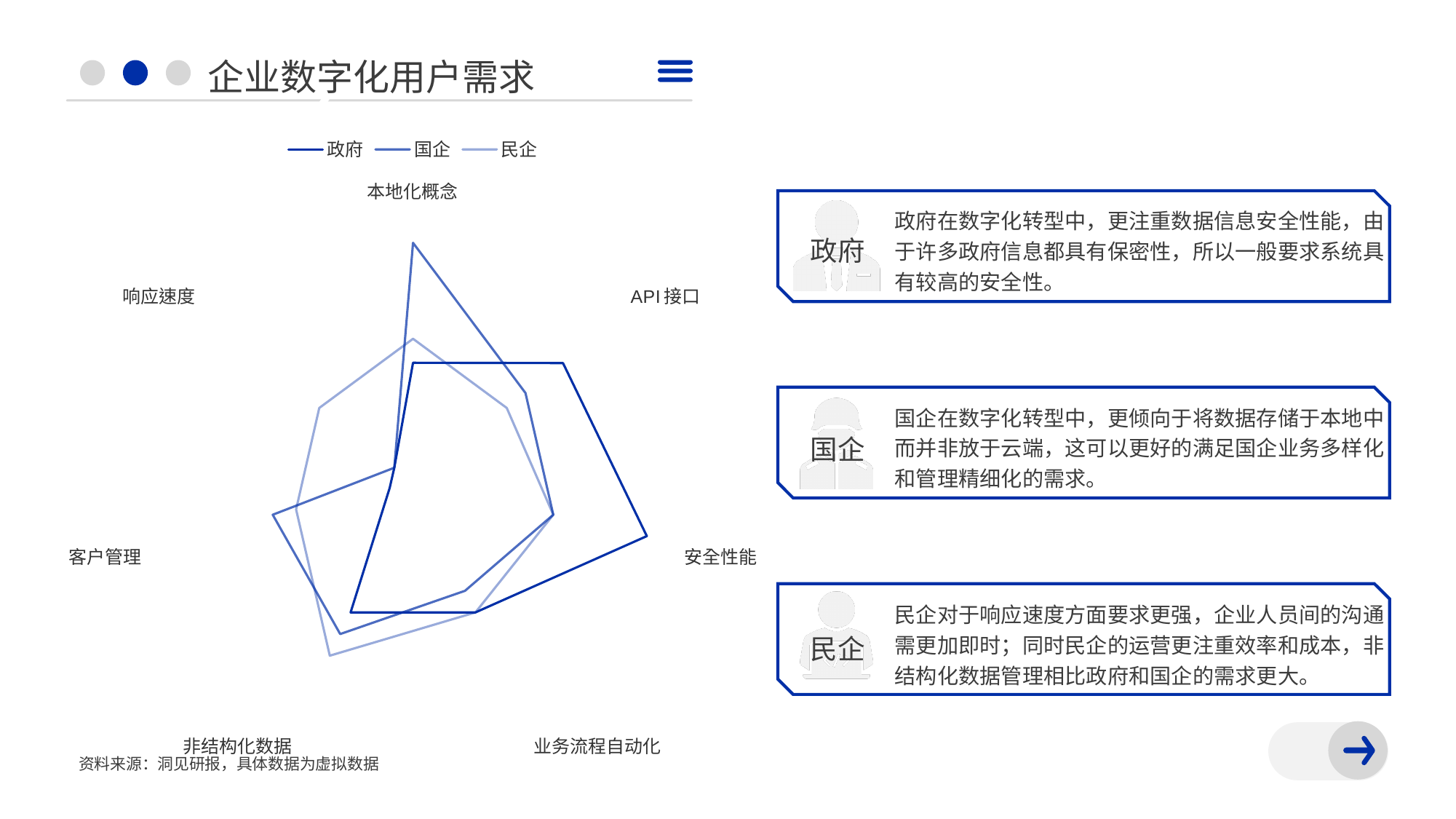
Which series has the highest value on the 非结构化数据 axis? 民企 How many series does the chart legend list? 3 Which series has the highest value on the 安全性能 axis? 政府 Which series are listed in the chart legend? 政府, 国企, 民企 What kind of chart is shown on the slide? Radar chart How many categories (axes) does the radar chart have? 7 What is the title of the slide containing the radar chart? 企业数字化用户需求 Which series has the highest value on the 客户管理 axis? 国企 On the API 接口 axis, which is larger: the value for 政府 or the value for 民企? 政府 On the 安全性能 axis, which is larger: the value for 国企 or the value for 政府? 政府